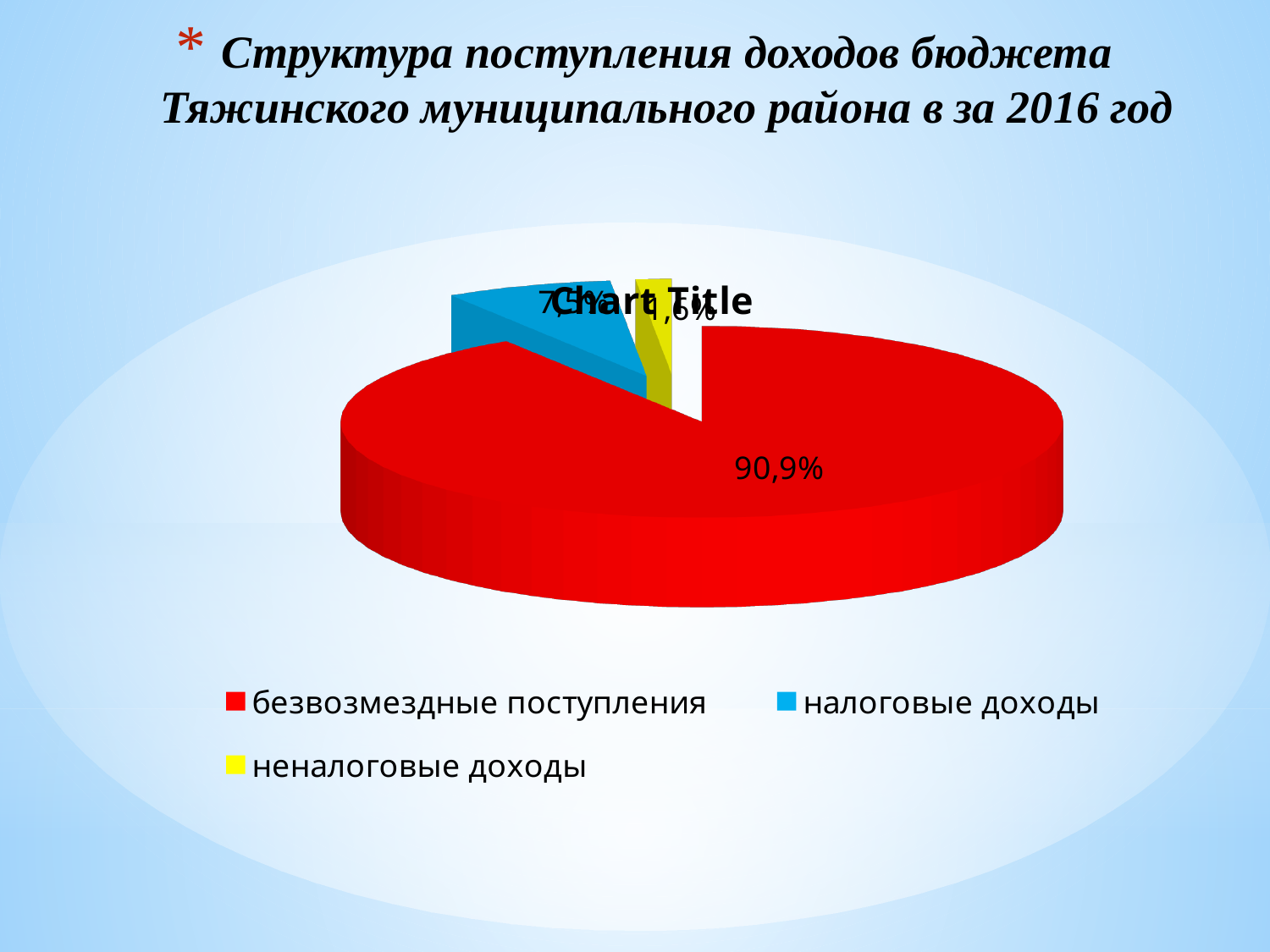
How many entries does the legend list? 3 What type of chart is shown on the slide? pie chart How many slices does the pie chart have? 3 Which is larger: the slice for налоговые доходы or the slice for неналоговые доходы? налоговые доходы What colour is the slice for неналоговые доходы? yellow Which category has the smallest slice of the pie? неналоговые доходы Which category has the largest slice of the pie? безвозмездные поступления What share of the pie does безвозмездные поступления have? 90,9% Which is larger: the slice for безвозмездные поступления or the slice for налоговые доходы? безвозмездные поступления What colour is the slice for налоговые доходы? blue